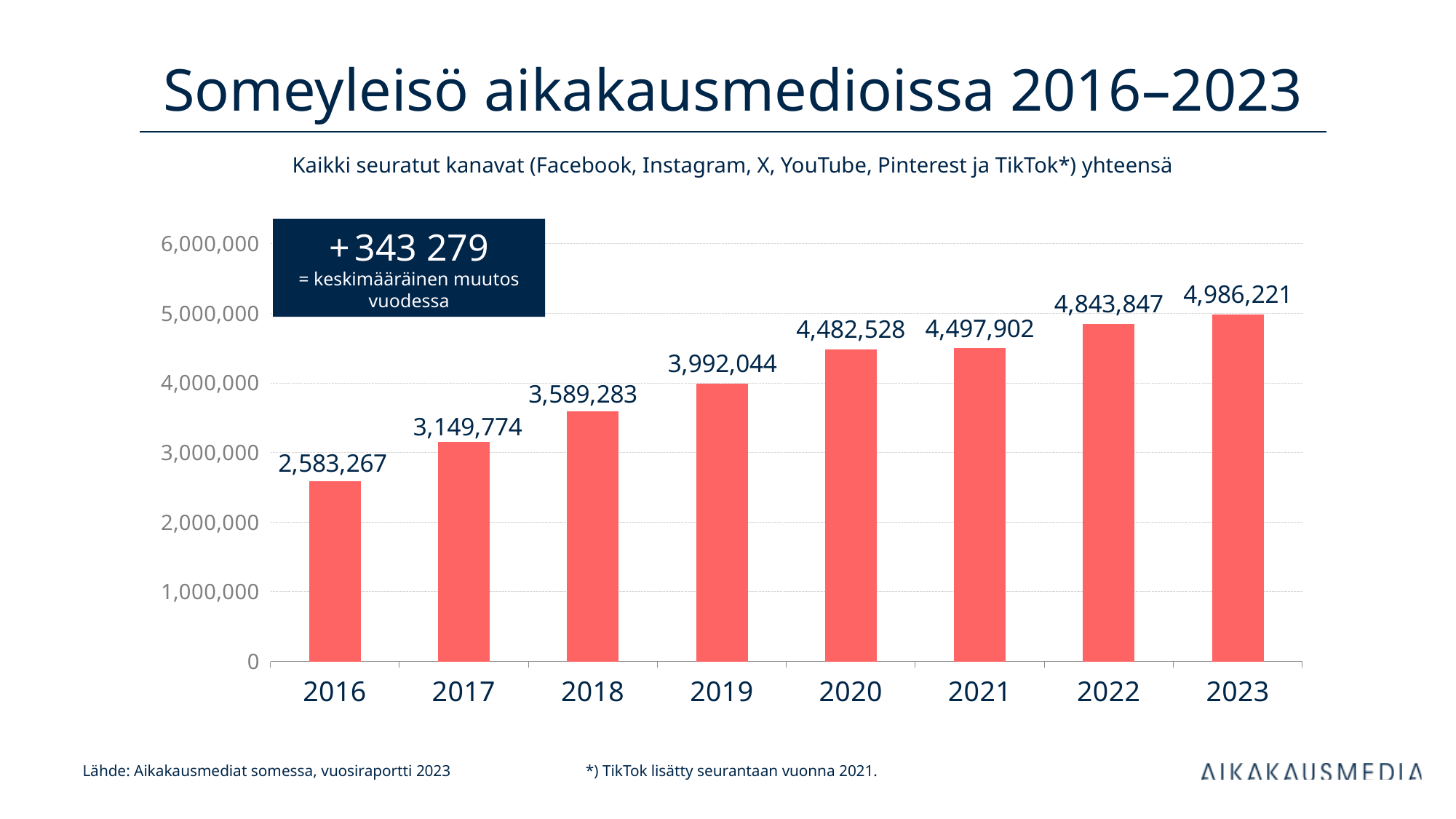
Which year has the highest value? 2023 What is the value for 2019? 3,992,044 How many years are shown on the x axis? 8 What is the value for 2016? 2,583,267 What is the value for 2022? 4,843,847 What is the difference between the values for 2023 and 2016? 2,402,954 What kind of chart is shown on the slide? bar chart Which year has the lowest value? 2016 Which is larger, the value for 2018 or the value for 2020? 2020 Is the value for 2019 greater or less than 4,000,000? less Do the values rise or fall from 2016 to 2023? rise What is the difference between the values for 2022 and 2021? 345,945